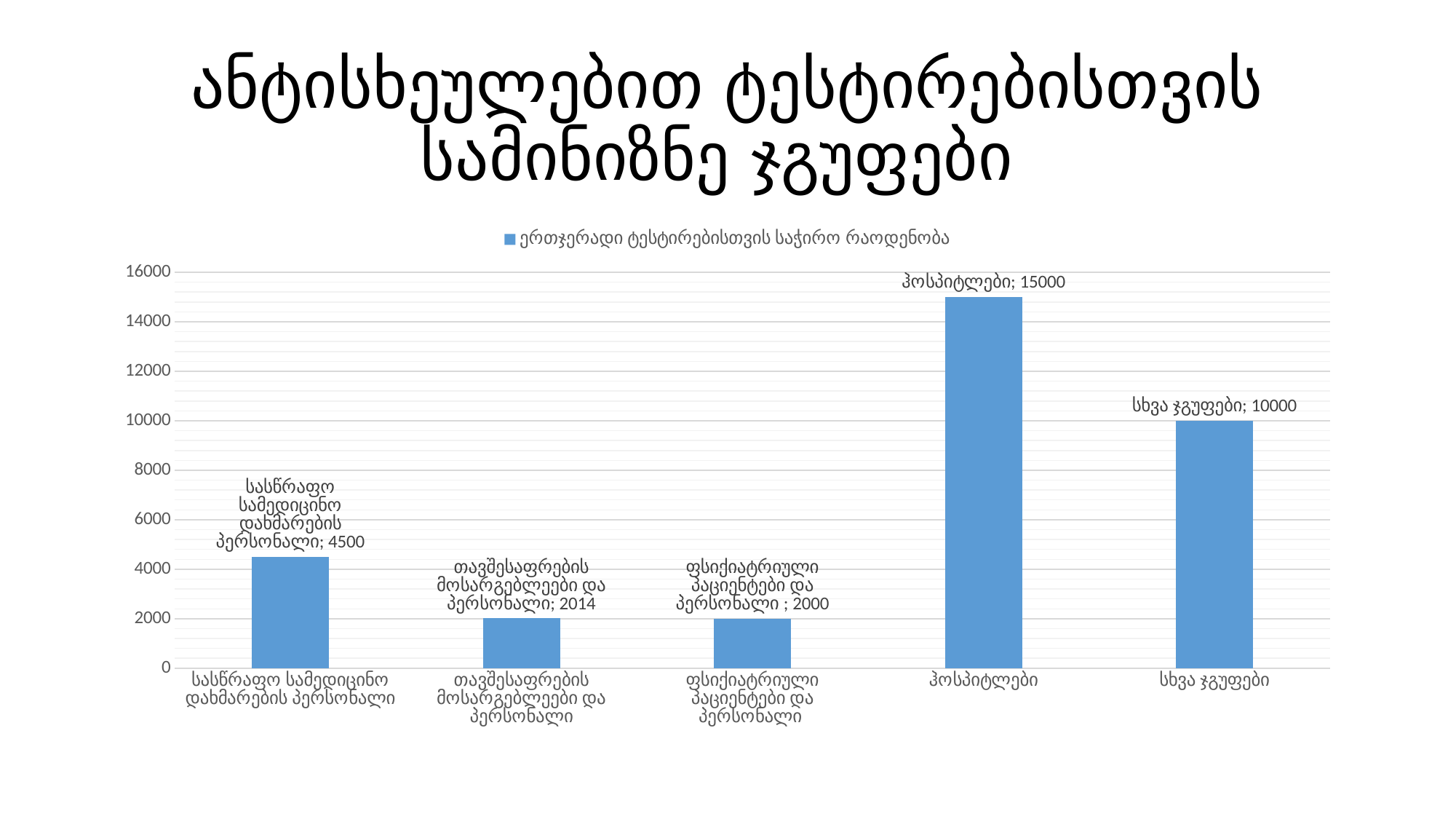
What is the difference between the values for ჰოსპიტლები and სხვა ჯგუფები? 5000 How many categories are shown on the x axis? 5 What is the value for ფსიქიატრიული პაციენტები და პერსონალი? 2000 What is the legend entry of the chart? ერთჯერადი ტესტირებისთვის საჭირო რაოდენობა Which category has the lowest value? ფსიქიატრიული პაციენტები და პერსონალი Which is larger, the value for სასწრაფო სამედიცინო დახმარების პერსონალი or the value for სხვა ჯგუფები? სხვა ჯგუფები What is the value for სასწრაფო სამედიცინო დახმარების პერსონალი? 4500 What is the value for სხვა ჯგუფები? 10000 What type of chart is shown on the slide? bar chart Which category has the highest value? ჰოსპიტლები What is the value for ჰოსპიტლები? 15000 What is the value for თავშესაფრების მოსარგებლეები და პერსონალი? 2014